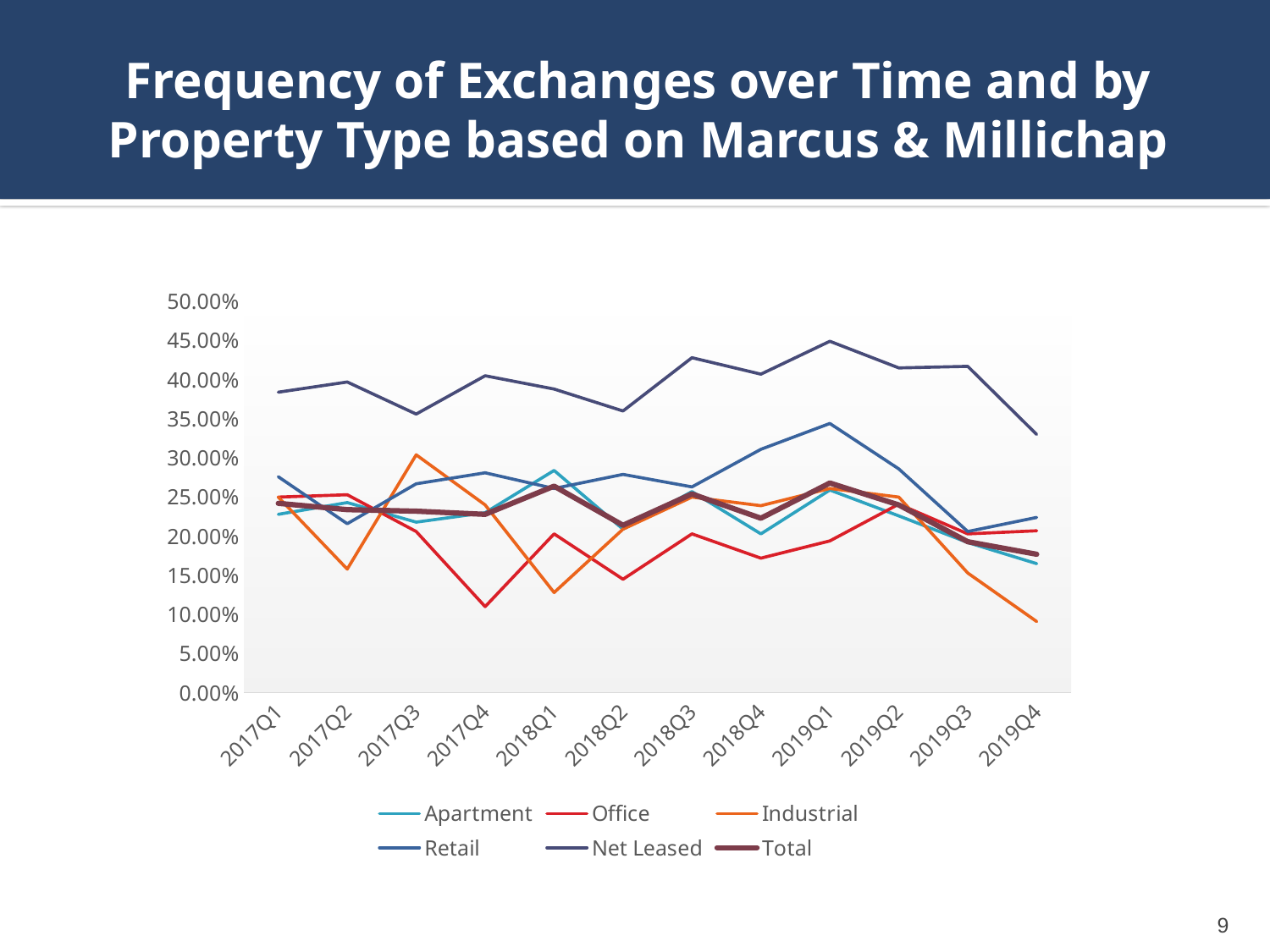
What is the title of the slide containing the chart? Frequency of Exchanges over Time and by Property Type based on Marcus & Millichap In which quarter does the Net Leased series reach its highest value? 2019Q1 Is the value for Net Leased in 2019Q1 greater or less than 40.00%? greater Which series has the lowest value in 2019Q4? Industrial In 2019Q1, which is larger: Retail or Office? Retail Does the Net Leased line rise or fall from 2019Q3 to 2019Q4? fall How many series does the legend list? 6 In which quarter does the Office series reach its lowest value? 2017Q4 Which series has the highest value in 2019Q1? Net Leased What kind of chart is shown on the slide? line chart How many quarters are plotted along the x axis? 12 Is the value for Industrial in 2019Q4 greater or less than 10.00%? less